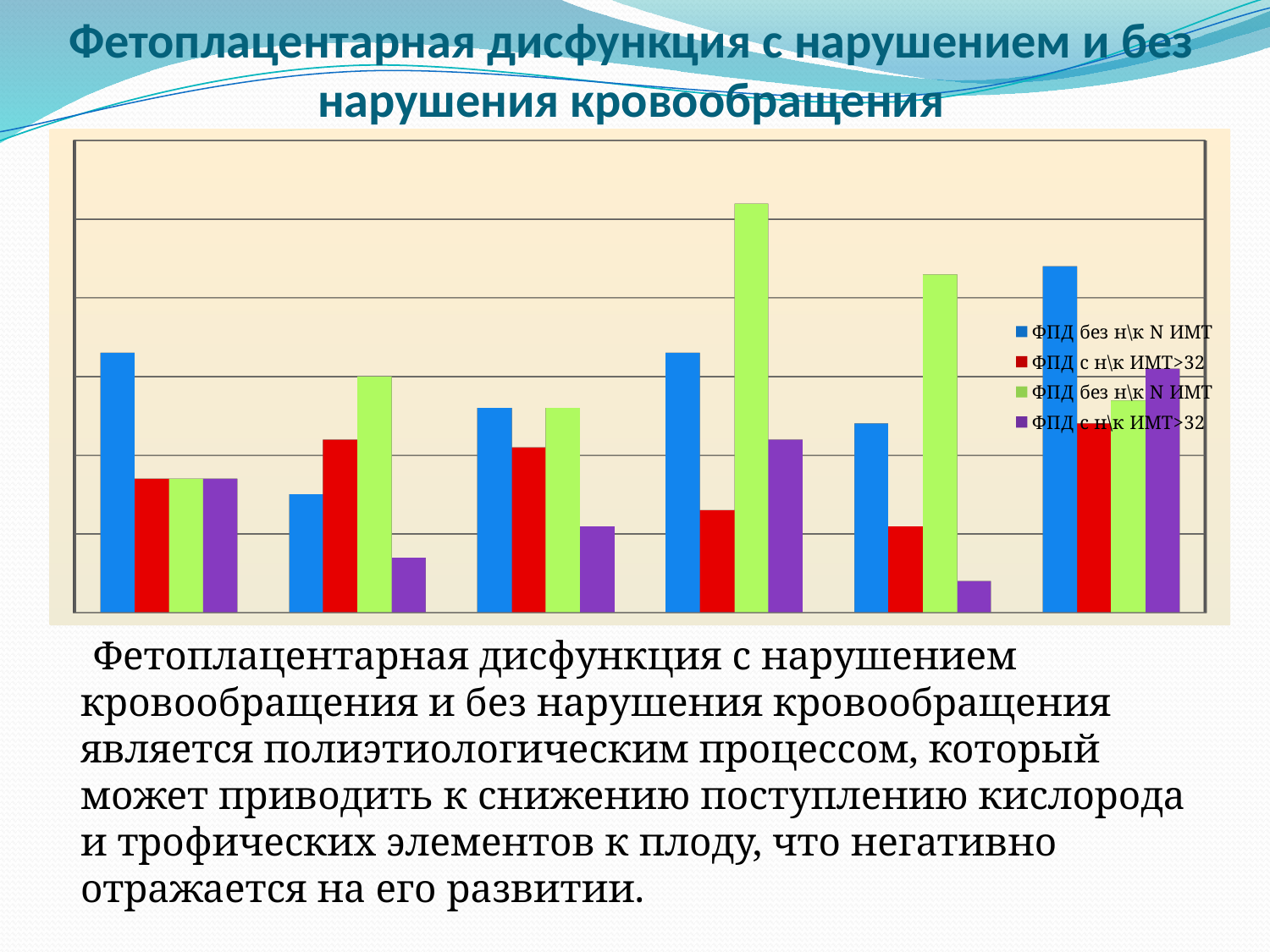
How many series does the chart legend list? 4 In the fifth group of bars from the left, which colour bar is the shortest? purple What is the first entry in the chart legend? ФПД без н\к N ИМТ What kind of chart is shown on the slide? bar chart In the third group of bars from the left, which is taller: the blue bar or the red bar? the blue bar In the first group of bars from the left, which colour bar is the tallest? blue In the fourth group of bars from the left, which colour bar is the tallest? light green In the sixth group of bars from the left, which is taller: the blue bar or the red bar? the blue bar What is the title of the slide above the chart? Фетоплацентарная дисфункция с нарушением и без нарушения кровообращения Which group of bars contains the tallest bar in the whole chart? the fourth group from the left In the second group of bars from the left, which colour bar is the shortest? purple How many groups of bars are plotted along the x axis? 6